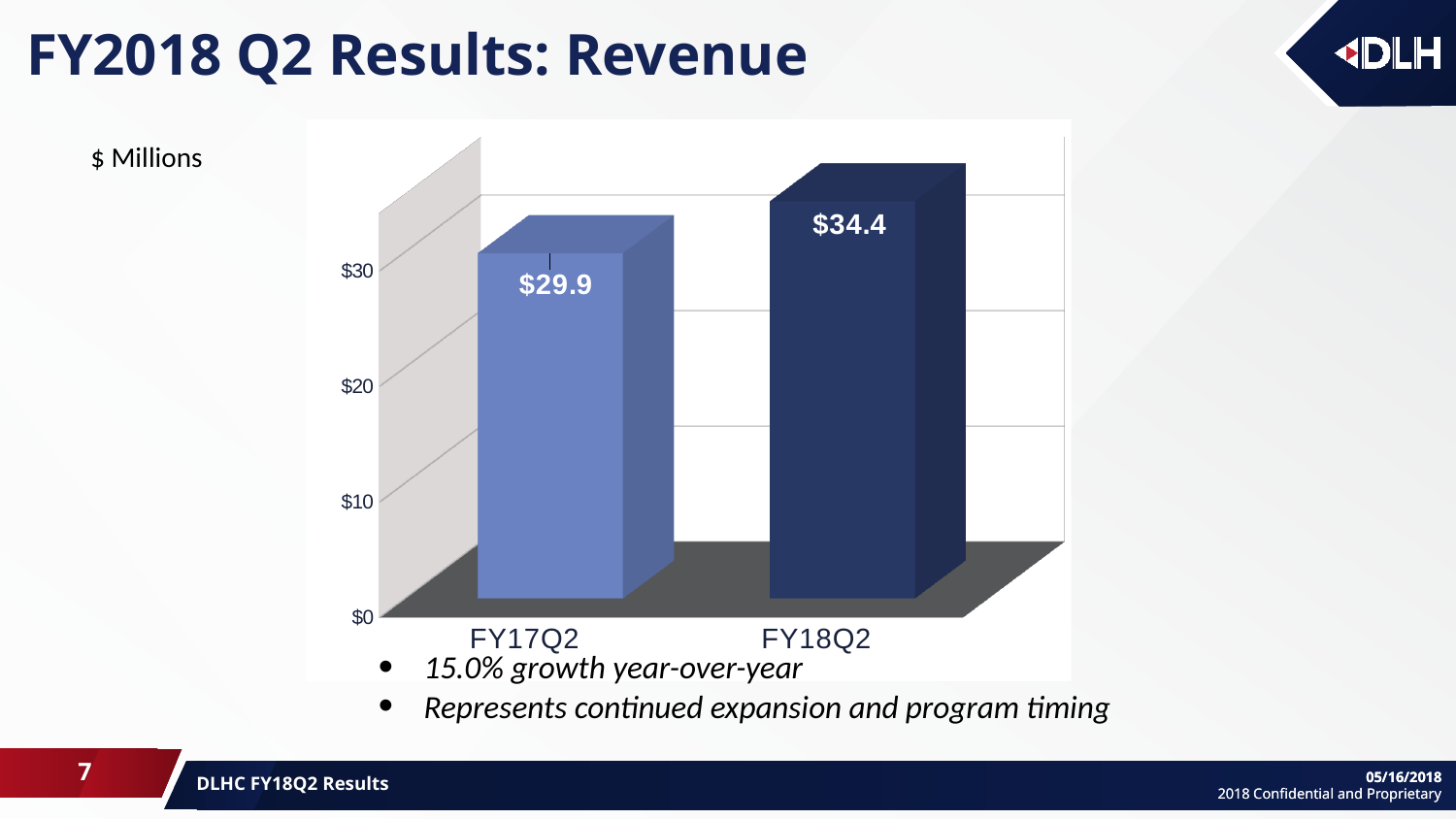
What kind of chart is shown on the slide? bar chart Which quarter has the lower revenue? FY17Q2 Which quarter has the higher revenue? FY18Q2 How many bars are shown in the chart? 2 Is the value for FY17Q2 greater or less than $20? greater Is the value for FY18Q2 greater or less than $30? greater What is the revenue value for FY18Q2? $34.4 Do the values rise or fall from FY17Q2 to FY18Q2? rise What is the difference in revenue between FY18Q2 and FY17Q2? $4.5 In what units are the chart values expressed? $ Millions Is the revenue for FY18Q2 larger or smaller than the revenue for FY17Q2? larger What is the revenue value for FY17Q2? $29.9